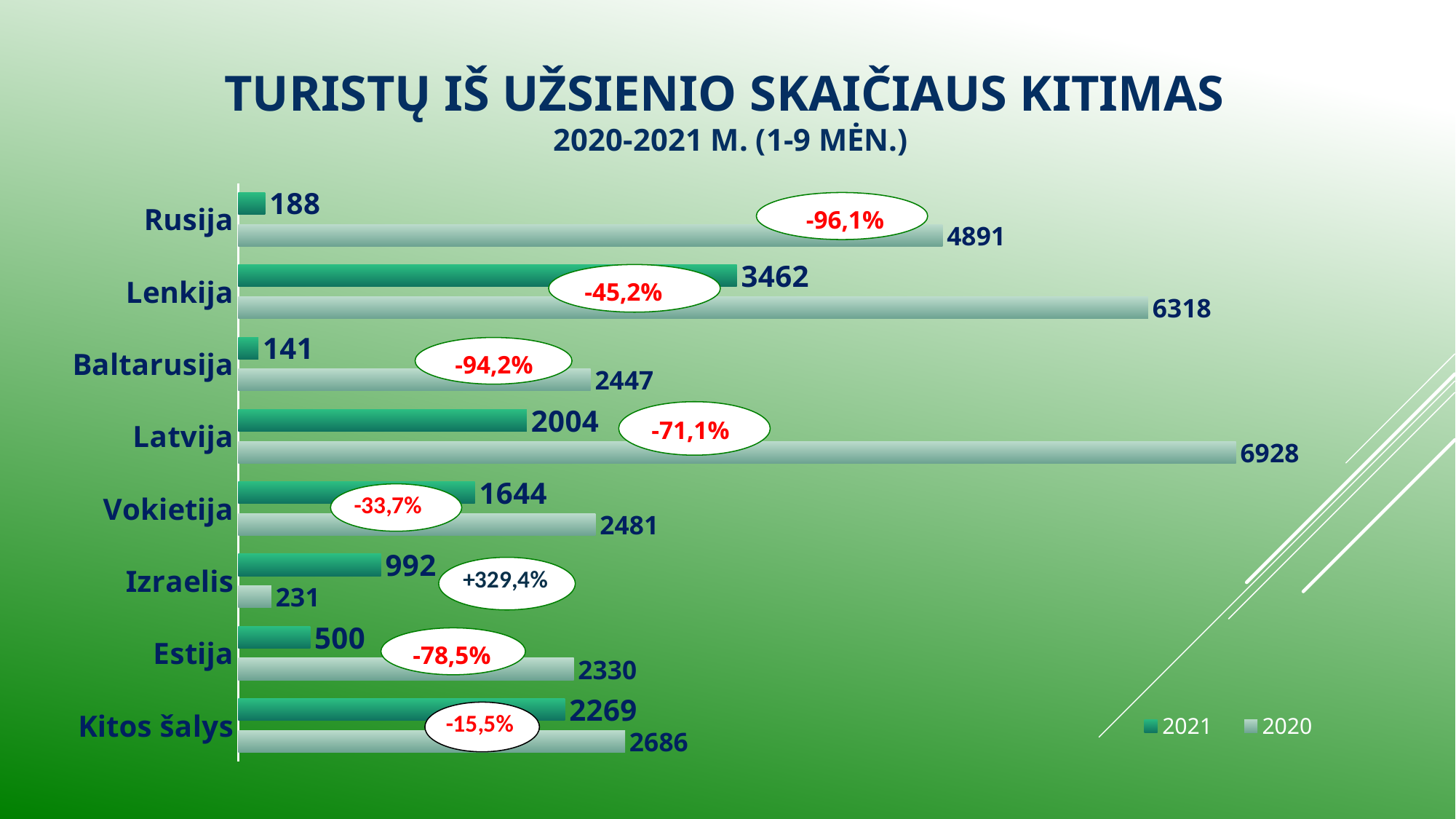
What percentage change is shown for Izraelis? +329,4% What is the title of the chart? TURISTŲ IŠ UŽSIENIO SKAIČIAUS KITIMAS What is the difference between the 2020 and 2021 values for Rusija? 4703 What is the 2020 value for Latvija? 6928 What is the 2021 value for Lenkija? 3462 How many series does the legend list? 2 What kind of chart is shown on the slide? Bar chart How many categories are shown on the chart? 8 Which category has the highest 2020 value? Latvija Which is larger for Estija, the 2020 value or the 2021 value? 2020 Which category has the lowest 2021 value? Baltarusija What is the 2021 value for Izraelis? 992